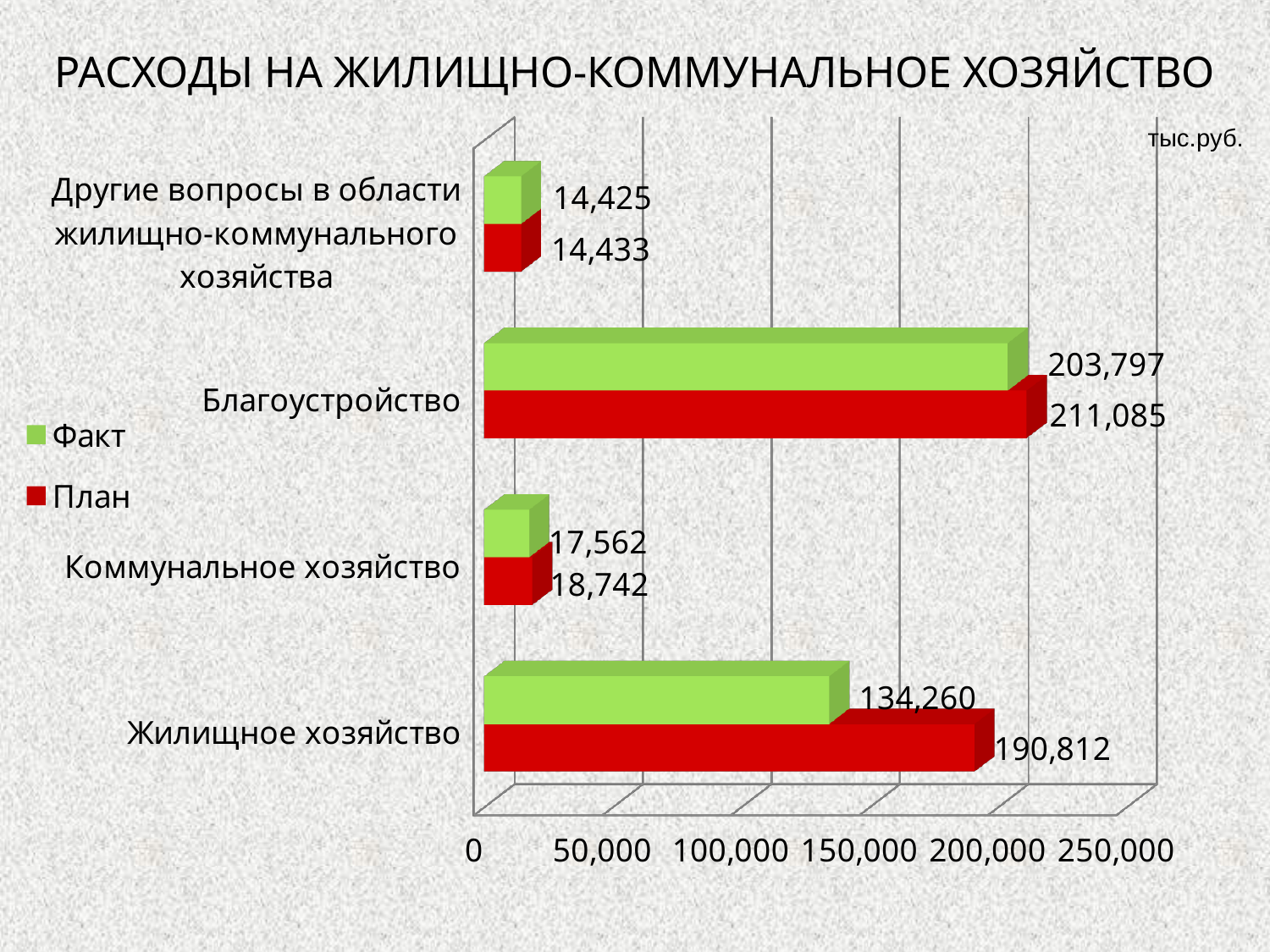
What kind of chart is shown on the slide? Bar chart How many categories are shown on the chart? 4 What is the Факт value for Коммунальное хозяйство? 17,562 What is the План value for Другие вопросы в области жилищно-коммунального хозяйства? 14,433 What is the difference between the План and Факт values for Жилищное хозяйство? 56,552 What unit is indicated for the values on the chart? тыс.руб. Which is larger for Коммунальное хозяйство, the Факт value or the План value? План What is the План value for Жилищное хозяйство? 190,812 Which category has the highest План value? Благоустройство How many series does the legend list? 2 Which category has the lowest Факт value? Другие вопросы в области жилищно-коммунального хозяйства What is the Факт value for Благоустройство? 203,797